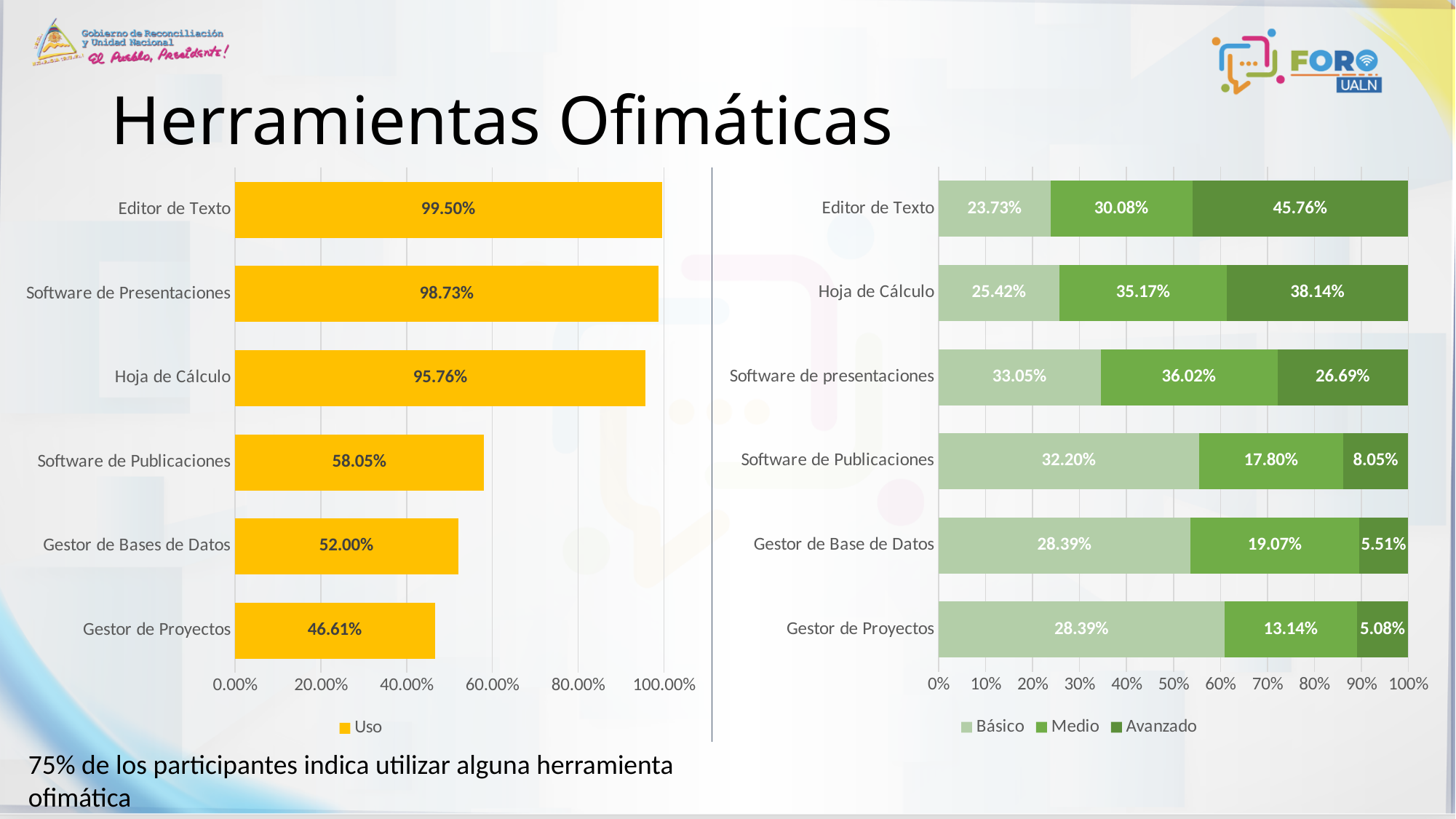
In the right chart, what is the total of the stacked bar for Software de Publicaciones? 58.05% In the left chart, which category has the highest Uso value? Editor de Texto What kind of chart is the chart on the right? Stacked bar chart In the right chart, what is the Avanzado value for Editor de Texto? 45.76% In the right chart, what is the Medio value for Software de presentaciones? 36.02% In the left chart, what series name does the legend show? Uso In the right chart, which is larger for Hoja de Cálculo: the Básico value or the Avanzado value? Avanzado In the left chart, what is the Uso value for Hoja de Cálculo? 95.76% In the left chart, which category has the lowest Uso value? Gestor de Proyectos In the left chart, how many categories are plotted? 6 In the left chart, what is the difference between the Uso values for Editor de Texto and Gestor de Proyectos? 52.89% In the right chart, how many series does the legend list? 3